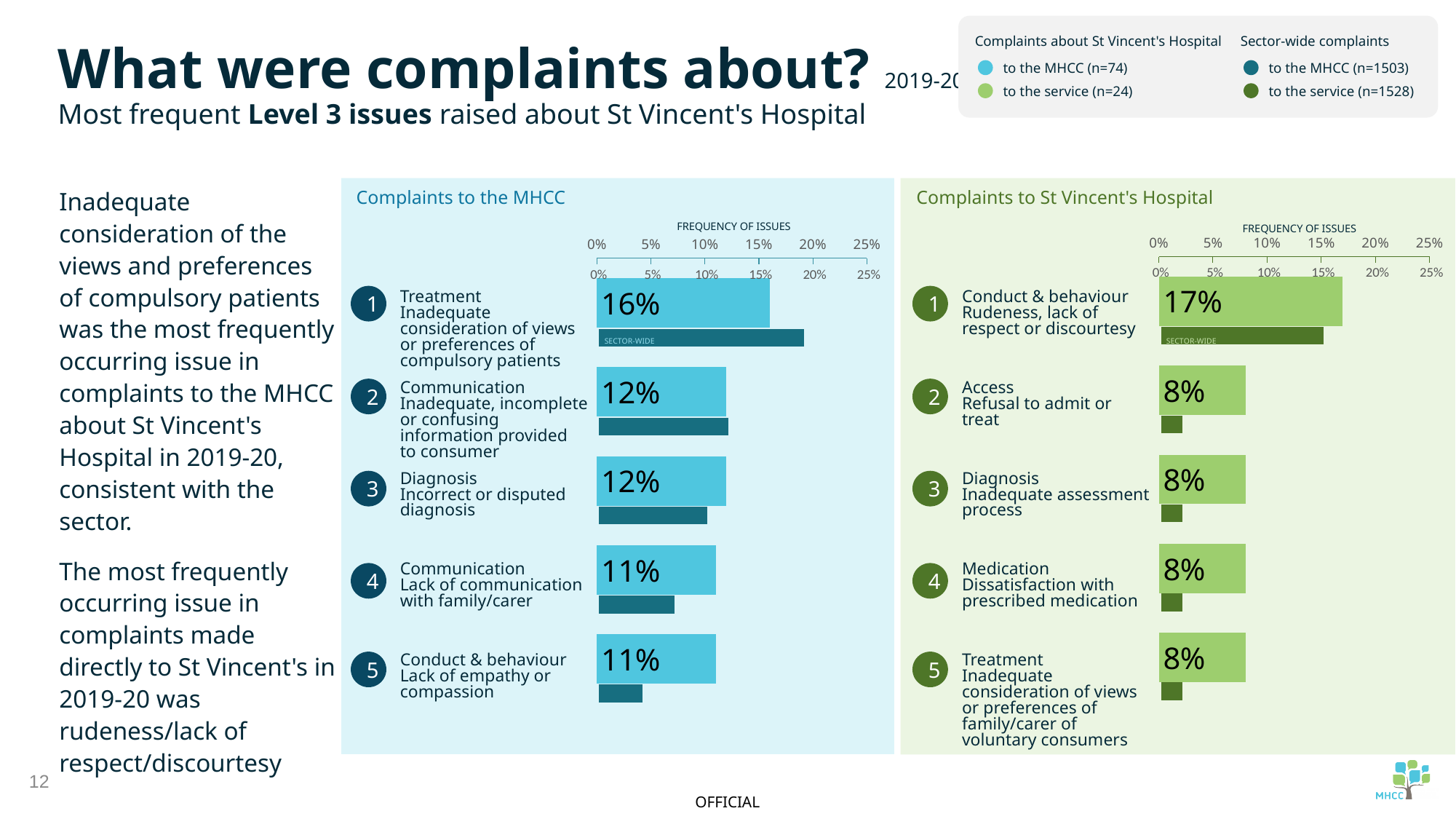
In the 'Complaints to St Vincent's Hospital' chart, is the sector-wide bar for Access greater or less than 5%? less In the 'Complaints to St Vincent's Hospital' chart, what is the frequency of issues for Conduct & behaviour (rudeness, lack of respect or discourtesy)? 17% In the 'Complaints to the MHCC' chart, what is the frequency of issues for Treatment (inadequate consideration of views or preferences of compulsory patients)? 16% In the 'Complaints to St Vincent's Hospital' chart, which issue has the highest frequency? Conduct & behaviour In the 'Complaints to the MHCC' chart, what is the difference between the frequency for Treatment and the frequency for Diagnosis? 4% In the 'Complaints to St Vincent's Hospital' chart, what is the frequency of issues for Access (refusal to admit or treat)? 8% In the 'Complaints to the MHCC' chart, is the sector-wide bar for Treatment greater or less than 15%? greater How many issues are listed in the 'Complaints to the MHCC' chart? 5 What kind of chart is the 'Complaints to St Vincent's Hospital' chart? Bar chart In the 'Complaints to the MHCC' chart, what is the frequency of issues for Conduct & behaviour (lack of empathy or compassion)? 11% In the 'Complaints to St Vincent's Hospital' chart, what is the difference between the frequency for Conduct & behaviour and the frequency for Medication? 9% In the 'Complaints to the MHCC' chart, which issue has the highest frequency? Treatment